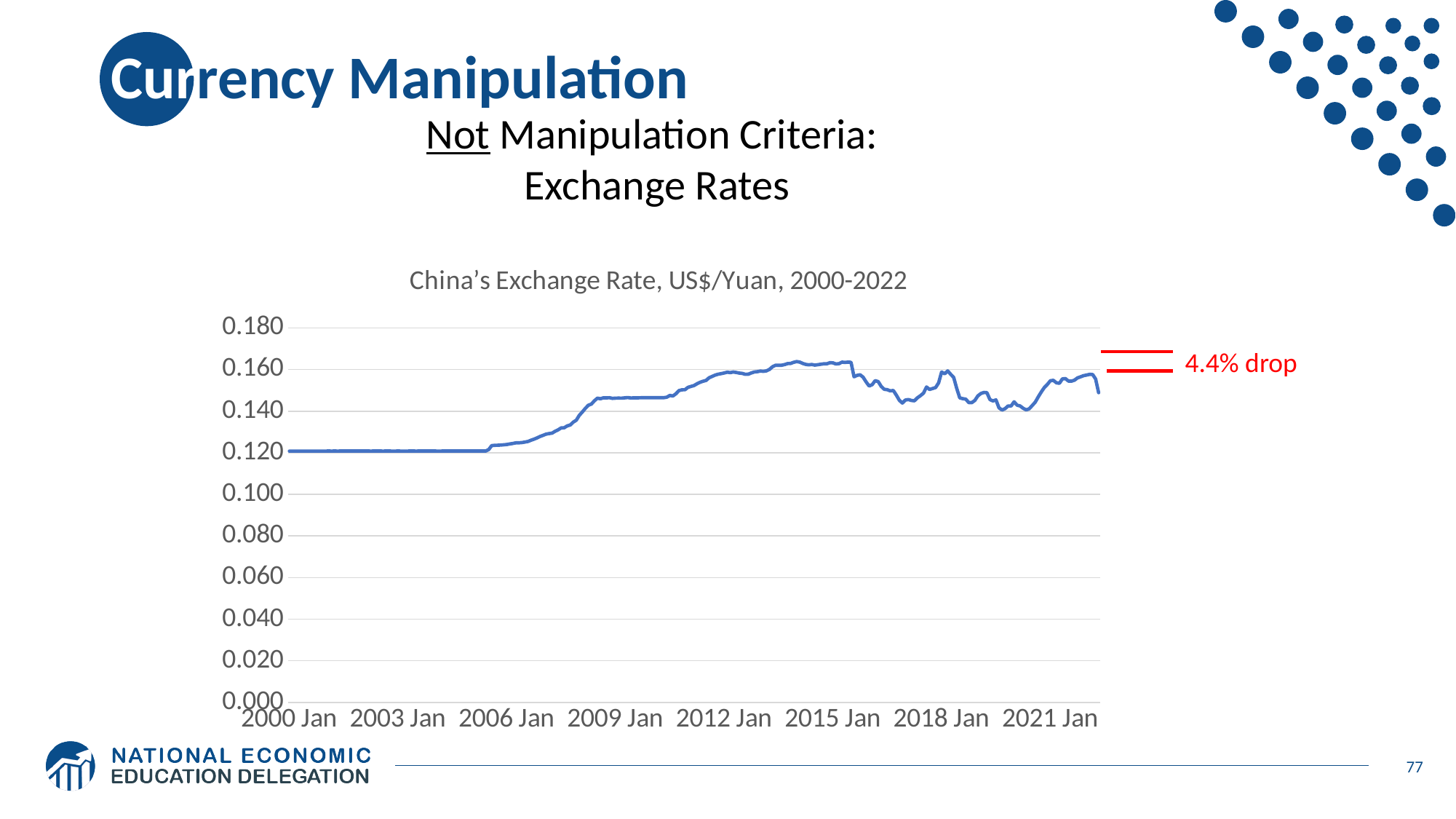
How many year labels are shown on the x axis? 8 Is the exchange rate value at 2021 Jan greater or less than 0.140? greater Which is higher, the exchange rate at 2012 Jan or at 2003 Jan? 2012 Jan Is the exchange rate value at 2015 Jan greater or less than 0.140? greater What does the red annotation next to the end of the line say? 4.4% drop What is the title of the chart? China's Exchange Rate, US$/Yuan, 2000-2022 Between 2015 Jan and 2018 Jan, does the exchange rate rise or fall? fall Is the highest point of the line greater or less than 0.180? less Between 2006 Jan and 2009 Jan, does the exchange rate rise or fall? rise What type of chart is shown on the slide? line chart